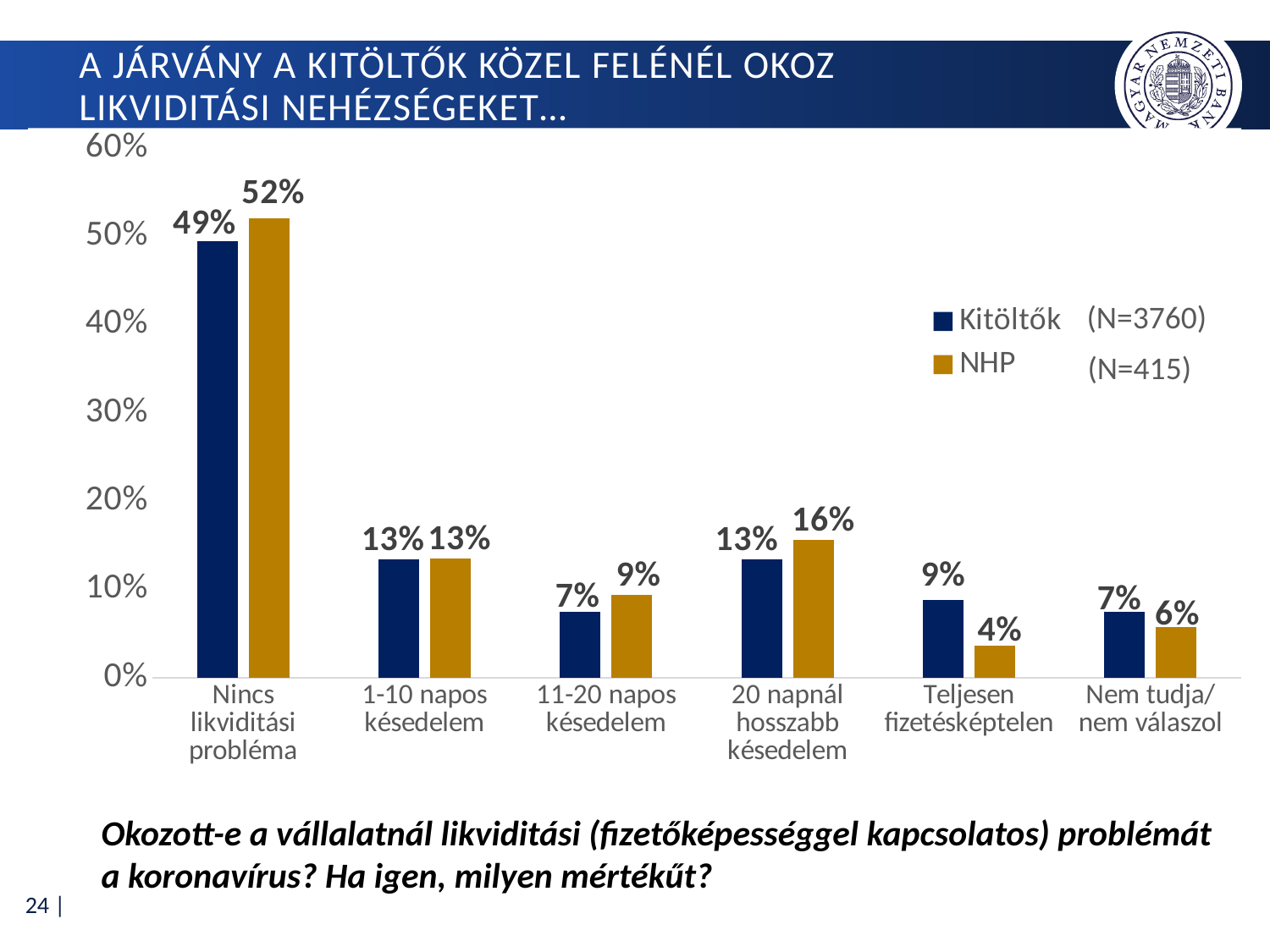
Which category has the highest value for the NHP series? Nincs likviditási probléma What is the difference between the NHP and Kitöltők values in the 'Nincs likviditási probléma' category? 3% How many series does the legend list? 2 How many categories are shown on the x axis? 6 What is the value for NHP in the 'Teljesen fizetésképtelen' category? 4% Is the Kitöltők value for 'Nincs likviditási probléma' greater or less than 40%? greater What sample size (N) is shown next to the Kitöltők legend entry? N=3760 In the 'Teljesen fizetésképtelen' category, which series has the larger value, Kitöltők or NHP? Kitöltők What is the value for NHP in the '20 napnál hosszabb késedelem' category? 16% What kind of chart is shown on the slide? bar chart Which category has the lowest value for the NHP series? Teljesen fizetésképtelen What is the value for Kitöltők in the 'Nincs likviditási probléma' category? 49%